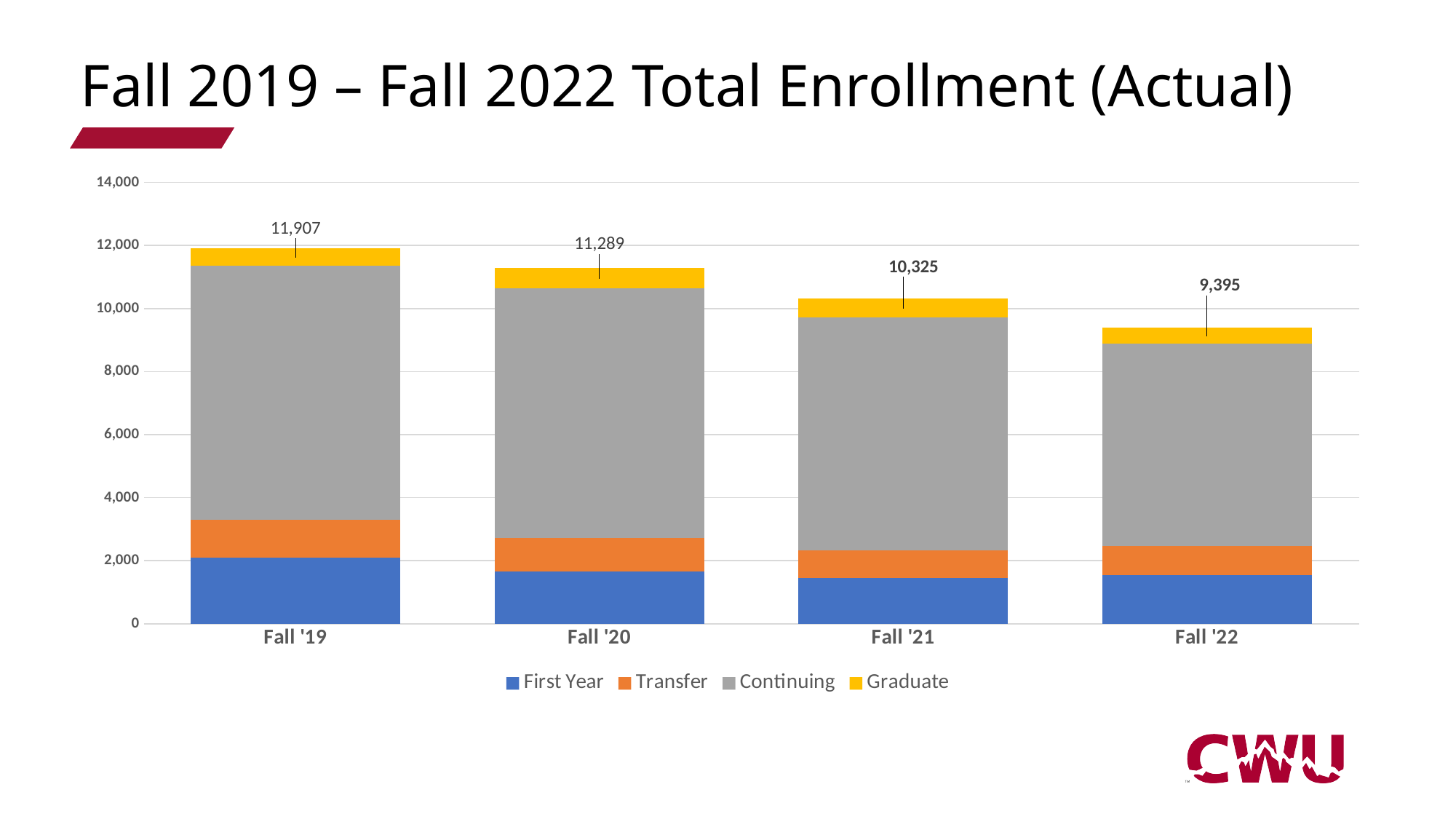
What is the total enrollment shown for Fall '19? 11,907 What is the total enrollment shown for Fall '22? 9,395 What is the difference in total enrollment between Fall '20 and Fall '21? 964 Which term has the highest total enrollment? Fall '19 What is the total enrollment shown for Fall '21? 10,325 Which is larger, the total enrollment for Fall '20 or Fall '21? Fall '20 How many series does the legend list? 4 What is the difference in total enrollment between Fall '19 and Fall '22? 2,512 Does total enrollment rise or fall from Fall '19 to Fall '22? fall Is the Continuing segment for Fall '22 greater or less than 8,000? less How many terms are shown on the x axis? 4 Which term has the lowest total enrollment? Fall '22